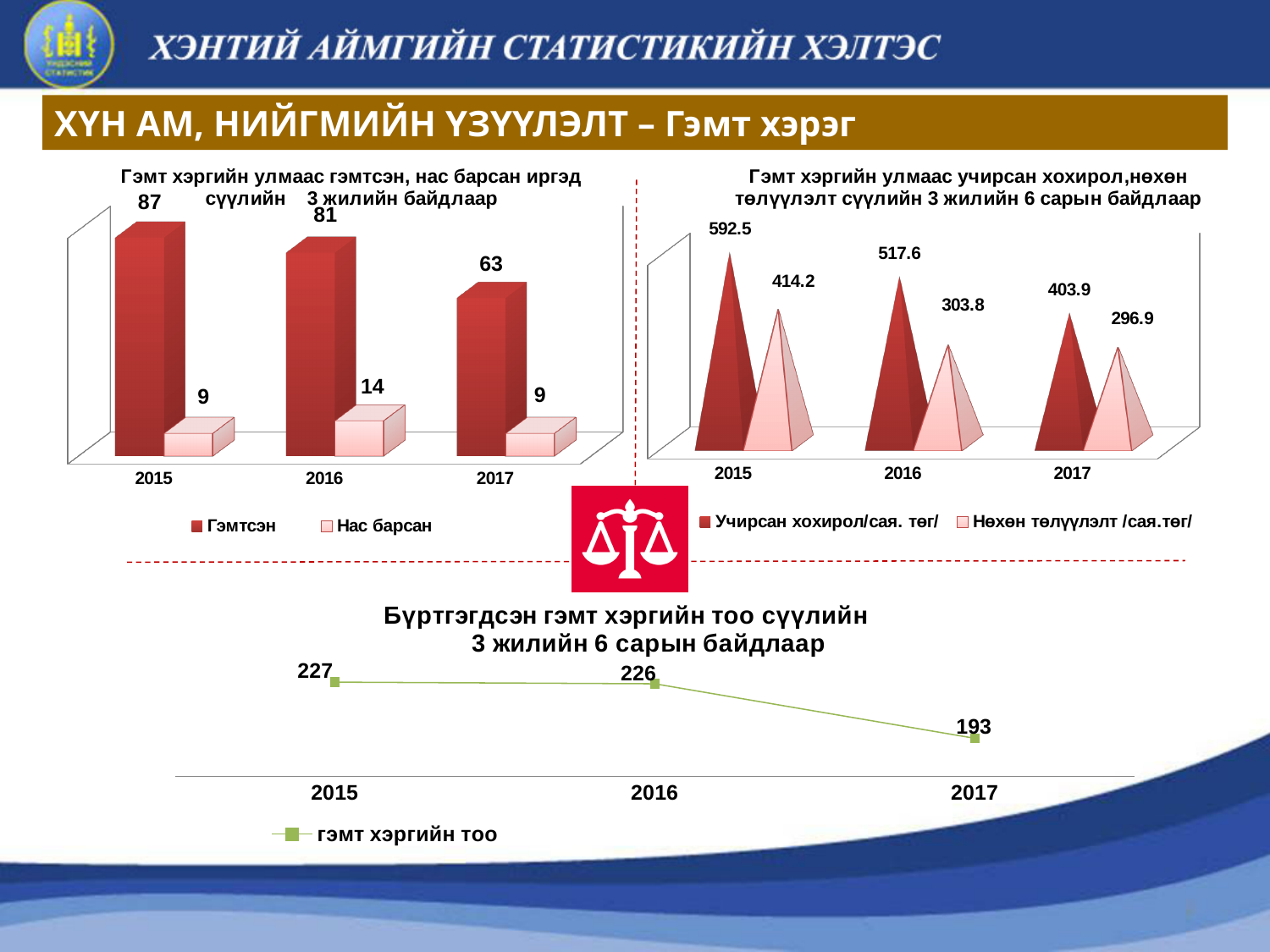
In the top-left chart (Гэмт хэргийн улмаас гэмтсэн, нас барсан иргэд), how many series does the legend list? 2 What kind of chart is the top-left chart (Гэмт хэргийн улмаас гэмтсэн, нас барсан иргэд)? bar chart In the top-left chart (Гэмт хэргийн улмаас гэмтсэн, нас барсан иргэд), what is the value for Гэмтсэн in 2015? 87 In the top-right chart (Гэмт хэргийн улмаас учирсан хохирол, нөхөн төлүүлэлт), what is the value for Нөхөн төлүүлэлт in 2017? 296.9 In the top-left chart (Гэмт хэргийн улмаас гэмтсэн, нас барсан иргэд), what is the value for Нас барсан in 2016? 14 In the top-right chart (Гэмт хэргийн улмаас учирсан хохирол, нөхөн төлүүлэлт), do the Учирсан хохирол values rise or fall from 2015 to 2017? fall In the bottom chart (Бүртгэгдсэн гэмт хэргийн тоо), what is the difference between the values for 2016 and 2017? 33 In the bottom chart (Бүртгэгдсэн гэмт хэргийн тоо), what is the value for 2017? 193 In the top-right chart (Гэмт хэргийн улмаас учирсан хохирол, нөхөн төлүүлэлт), which year has the highest value for Учирсан хохирол? 2015 In the top-left chart (Гэмт хэргийн улмаас гэмтсэн, нас барсан иргэд), what is the difference between the Гэмтсэн values for 2015 and 2017? 24 In the top-right chart (Гэмт хэргийн улмаас учирсан хохирол, нөхөн төлүүлэлт), what is the value for Учирсан хохирол in 2016? 517.6 In the top-left chart (Гэмт хэргийн улмаас гэмтсэн, нас барсан иргэд), which year has the lowest value for Гэмтсэн? 2017